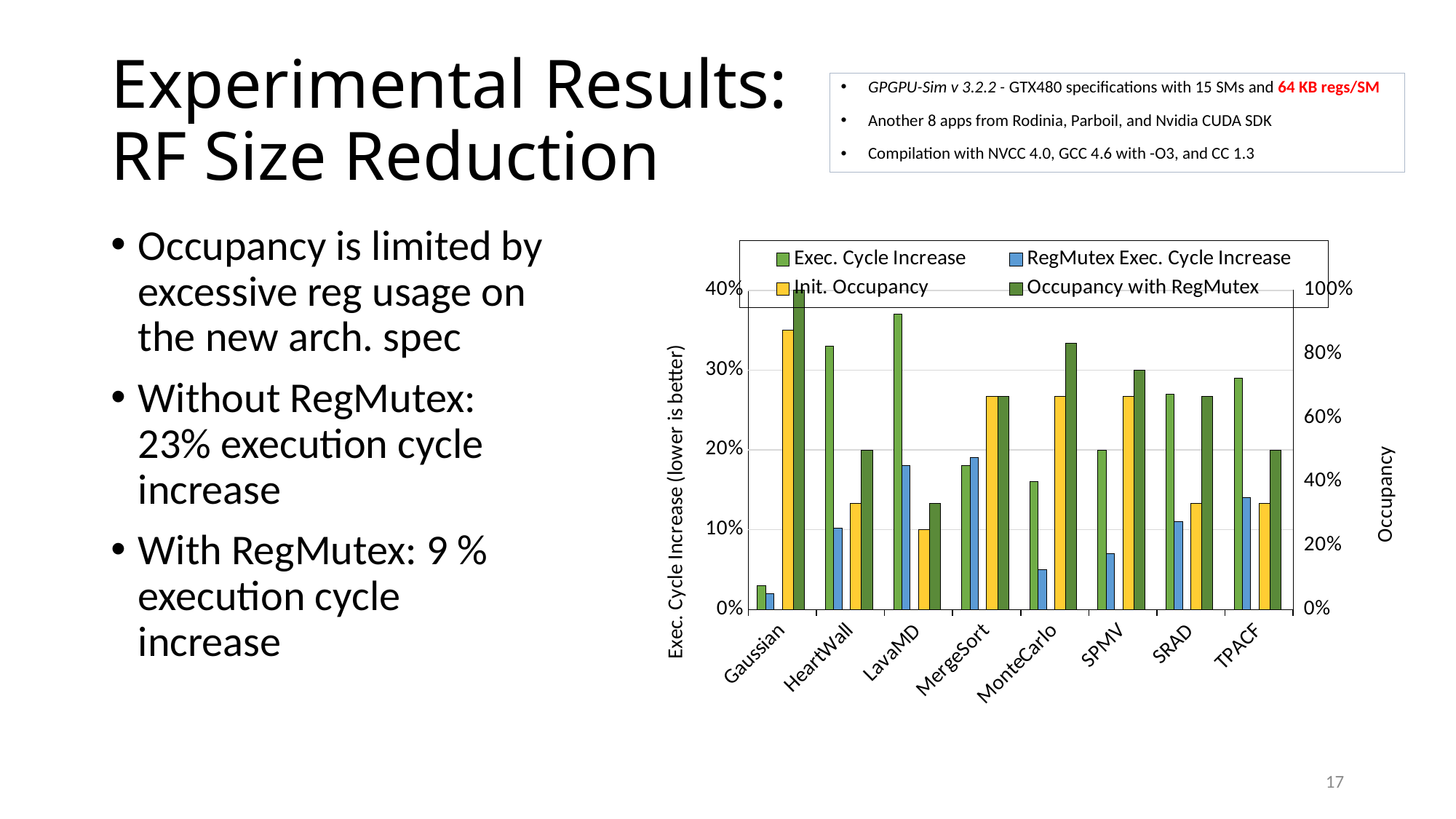
How many applications (categories) are shown on the x axis of the chart? 8 What kind of chart is shown on the slide? bar chart Is the Occupancy with RegMutex for MonteCarlo greater or less than 60%? greater What is the title of the left vertical axis of the chart? Exec. Cycle Increase (lower is better) Which has the larger Exec. Cycle Increase, HeartWall or MergeSort? HeartWall Is the Init. Occupancy for LavaMD greater or less than 40%? less Which application has the lowest Exec. Cycle Increase? Gaussian How many series does the chart legend list? 4 Is the Exec. Cycle Increase for HeartWall greater or less than 30%? greater Which application has the highest Exec. Cycle Increase? LavaMD Which application has the lowest Occupancy with RegMutex? LavaMD Which application has the highest Occupancy with RegMutex? Gaussian